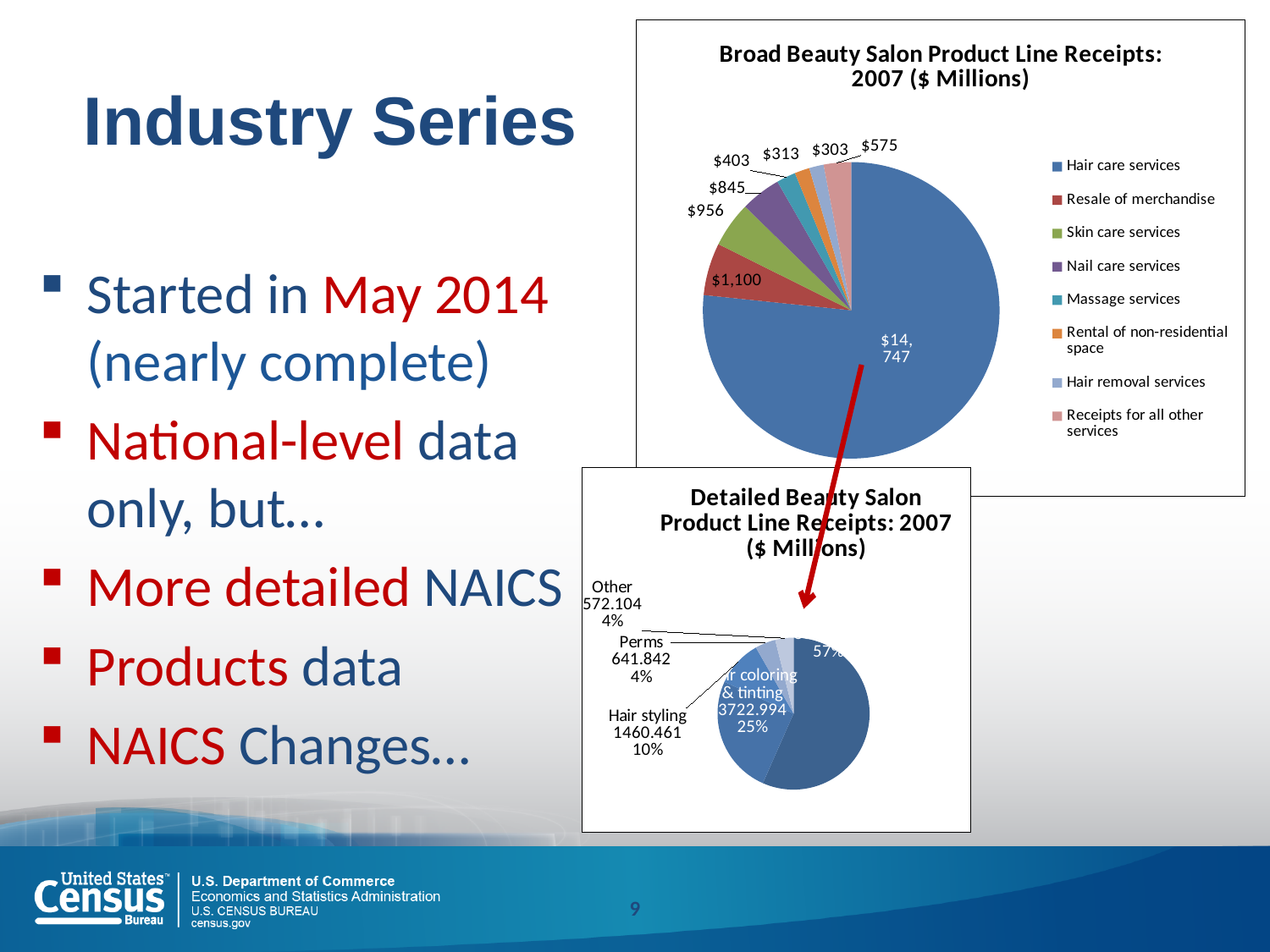
In the Broad Beauty Salon Product Line Receipts chart, what is the value for Hair care services? $14,747 In the Broad Beauty Salon Product Line Receipts chart, which category has the smallest receipts? Hair removal services How many categories does the legend of the Broad Beauty Salon Product Line Receipts chart list? 8 In the Detailed Beauty Salon Product Line Receipts chart, what percentage is shown for the largest slice? 57% In the Detailed Beauty Salon Product Line Receipts chart, what is the value for Perms? 641.842 In the Broad Beauty Salon Product Line Receipts chart, what is the value for Resale of merchandise? $1,100 In the Detailed Beauty Salon Product Line Receipts chart, what share of the pie is Hair styling? 10% In the Detailed Beauty Salon Product Line Receipts chart, what is the value for Hair coloring & tinting? 3722.994 In the Broad Beauty Salon Product Line Receipts chart, which is larger: Massage services or Receipts for all other services? Receipts for all other services In the Broad Beauty Salon Product Line Receipts chart, which category has the largest receipts? Hair care services In the Broad Beauty Salon Product Line Receipts chart, what is the difference between Skin care services and Nail care services? $111 What type of chart is the Broad Beauty Salon Product Line Receipts chart? Pie chart